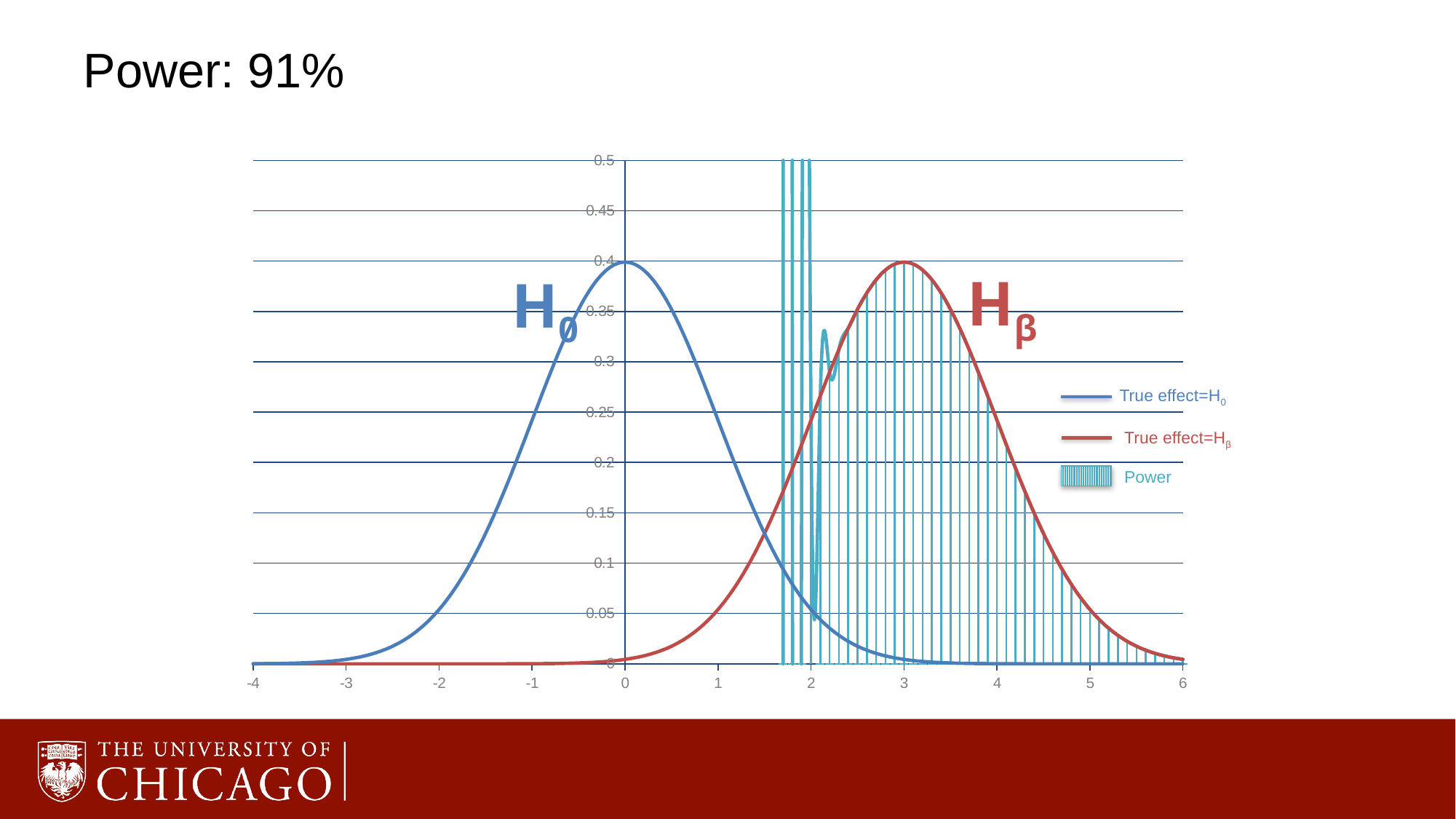
Which legend entry is drawn in red? True effect=Hβ Does the blue H0 curve rise or fall as x goes from 0 to 6? fall What power value is stated in the slide title? 91% Is the value of the blue H0 curve at x = 0 greater or less than 0.35? greater Is the value of the blue H0 curve at x = 2 greater or less than 0.1? less At x = 0, which curve is higher, the blue H0 curve or the red Hβ curve? the blue H0 curve Does the red Hβ curve rise or fall as x goes from -4 to 3? rise At x = 3, which curve is higher, the blue H0 curve or the red Hβ curve? the red Hβ curve Is the value of the red Hβ curve at x = 1 greater or less than 0.1? less How many tick labels are shown on the x axis? 11 How many entries does the chart legend list? 3 What kind of chart is shown on the slide? line chart